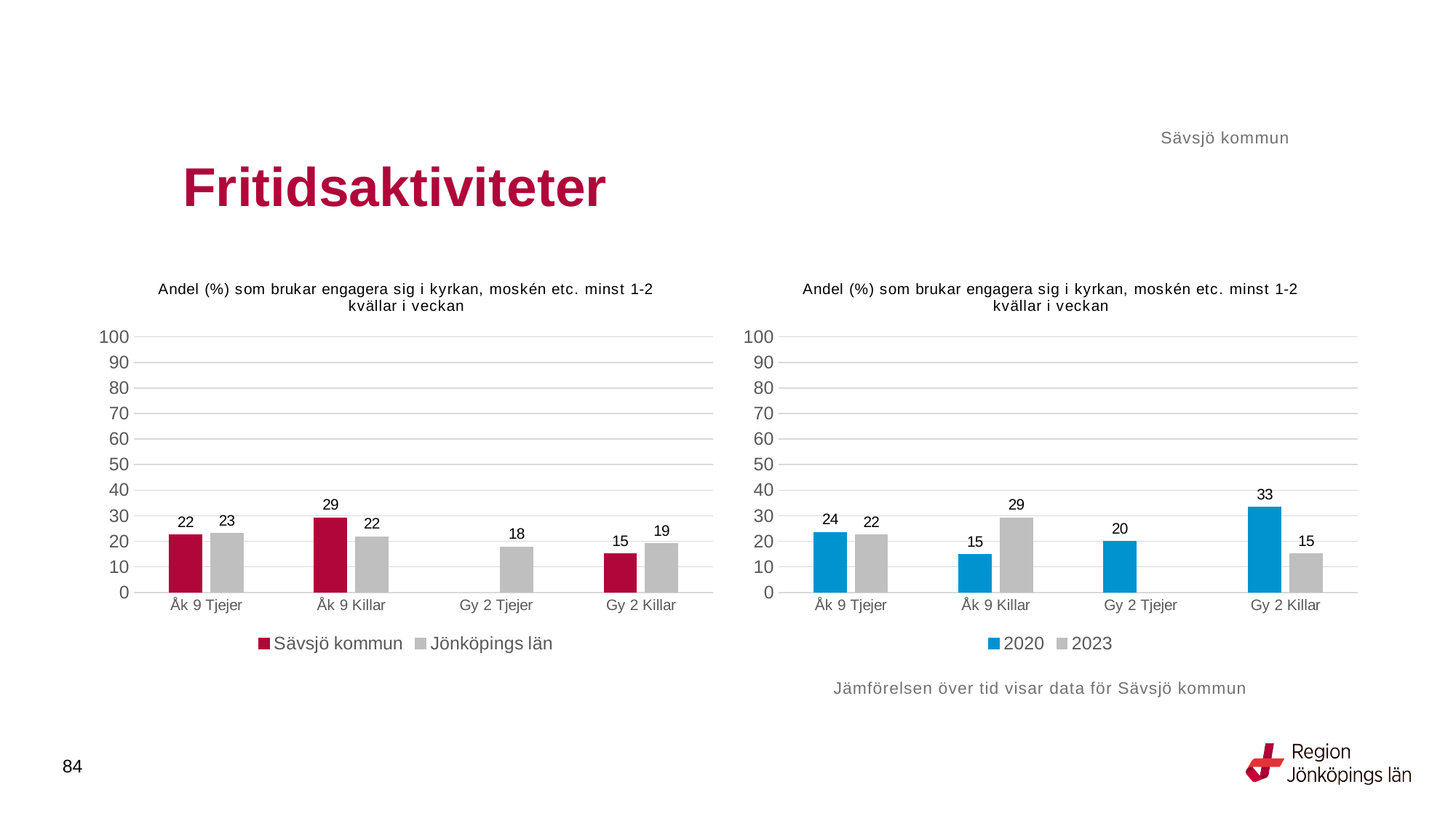
In the left chart, what is the difference between the Sävsjö kommun and Jönköpings län values for Åk 9 Killar? 7 In the right chart, what is the 2023 value for Åk 9 Killar? 29 In the right chart, is the 2020 value or the 2023 value larger for Åk 9 Tjejer? 2020 What type of chart is the left chart? Bar chart In the left chart, which category has the highest value for Sävsjö kommun? Åk 9 Killar In the right chart, which category has the lowest 2020 value? Åk 9 Killar In the left chart, what is the value for Jönköpings län for Gy 2 Tjejer? 18 How many series does the legend of the right chart list? 2 In the right chart, what is the 2020 value for Gy 2 Killar? 33 In the left chart, what is the value for Sävsjö kommun for Åk 9 Killar? 29 What are the two legend entries of the left chart? Sävsjö kommun and Jönköpings län In the right chart, what is the difference between the 2020 and 2023 values for Gy 2 Killar? 18